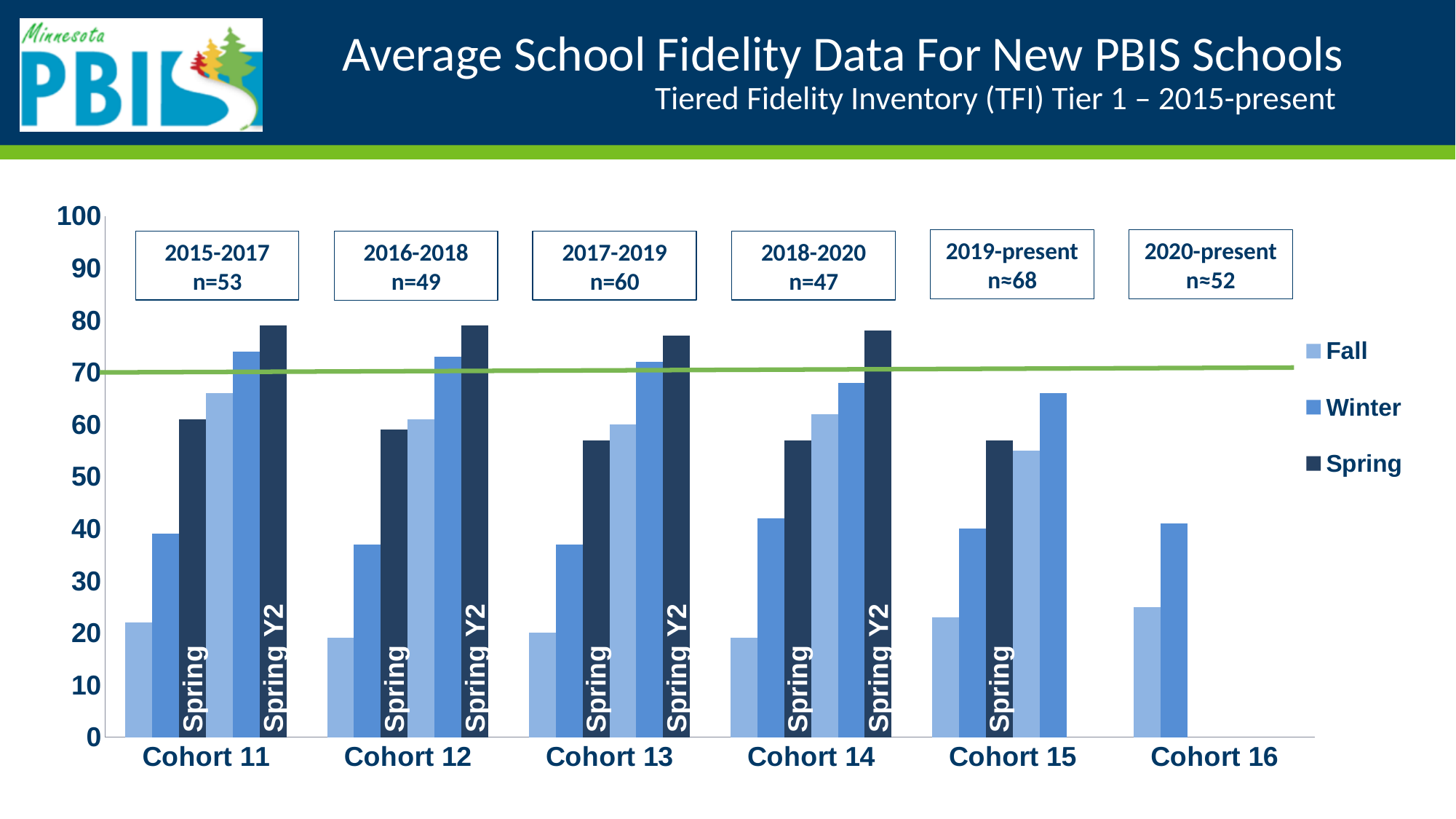
How many series does the legend list? 3 Is the Spring Y2 bar for Cohort 13 greater or less than 70? greater Within Cohort 11, do the bars rise or fall from the first Fall bar to the Spring Y2 bar? rise How many bars are plotted for Cohort 16? 2 What kind of chart is shown on the slide? bar chart Is the Spring bar for Cohort 15 greater or less than 50? greater Is the first Fall bar for Cohort 11 greater or less than 30? less How many cohorts are shown on the x axis? 6 At what value on the y axis is the green horizontal line drawn? 70 Which is larger for Cohort 14: the Spring bar or the Spring Y2 bar? Spring Y2 Which is larger: the tallest Winter bar for Cohort 15 or the Winter bar for Cohort 16? Cohort 15